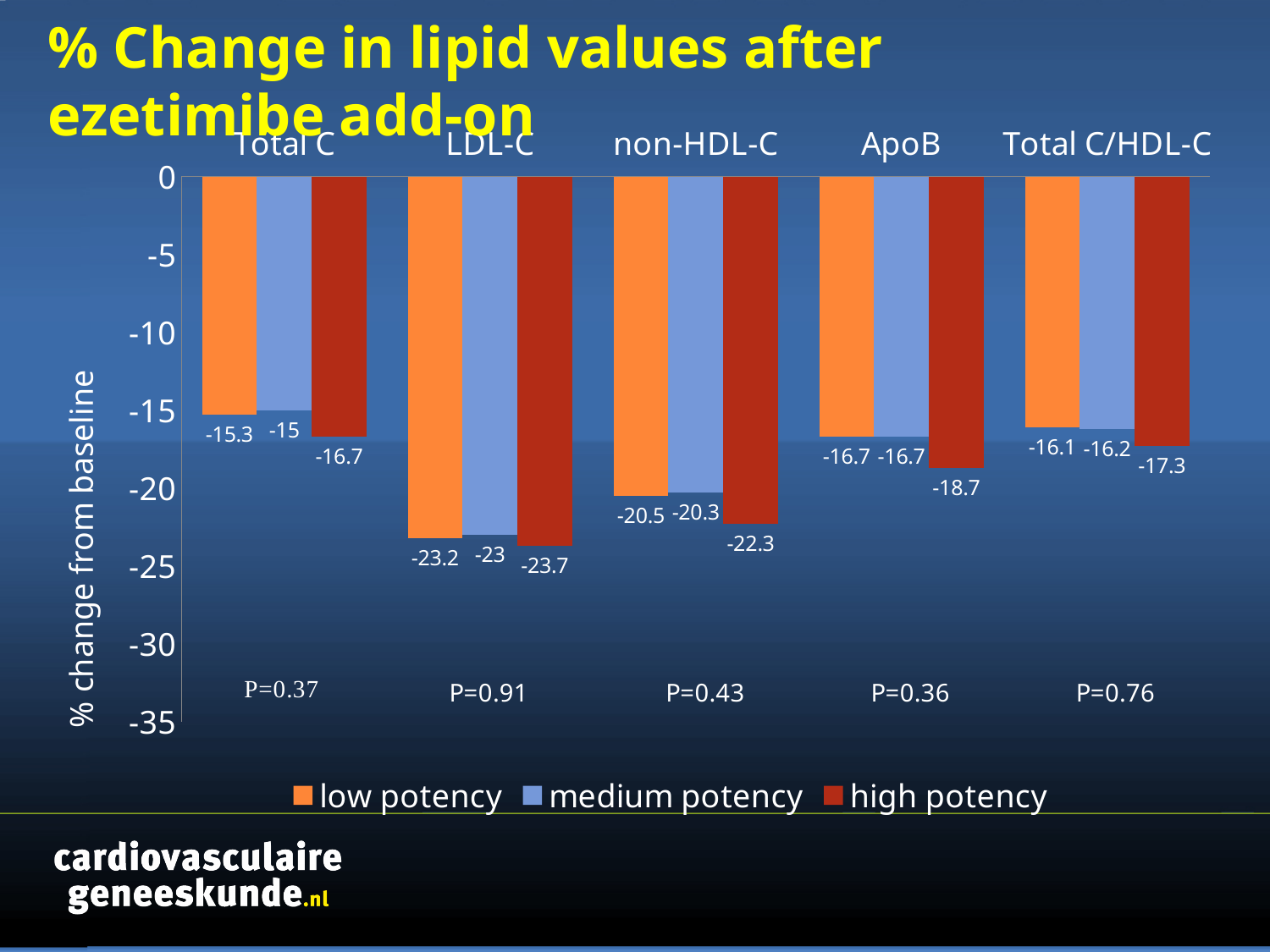
What kind of chart is shown on the slide? bar chart How many lipid categories are shown on the x axis? 5 What is the value for high potency in the ApoB category? -18.7 Which category has the lowest (most negative) value for high potency? LDL-C Which category has the highest (least negative) value for medium potency? Total C What is the value for medium potency in the non-HDL-C category? -20.3 What is the value for high potency in the Total C/HDL-C category? -17.3 How many series does the legend list? 3 What P value is shown under the LDL-C category? P=0.91 Which is larger (less negative): the low potency value for Total C or the low potency value for ApoB? Total C What is the difference between the low potency and high potency values in the non-HDL-C category? 1.8 What is the value for low potency in the LDL-C category? -23.2